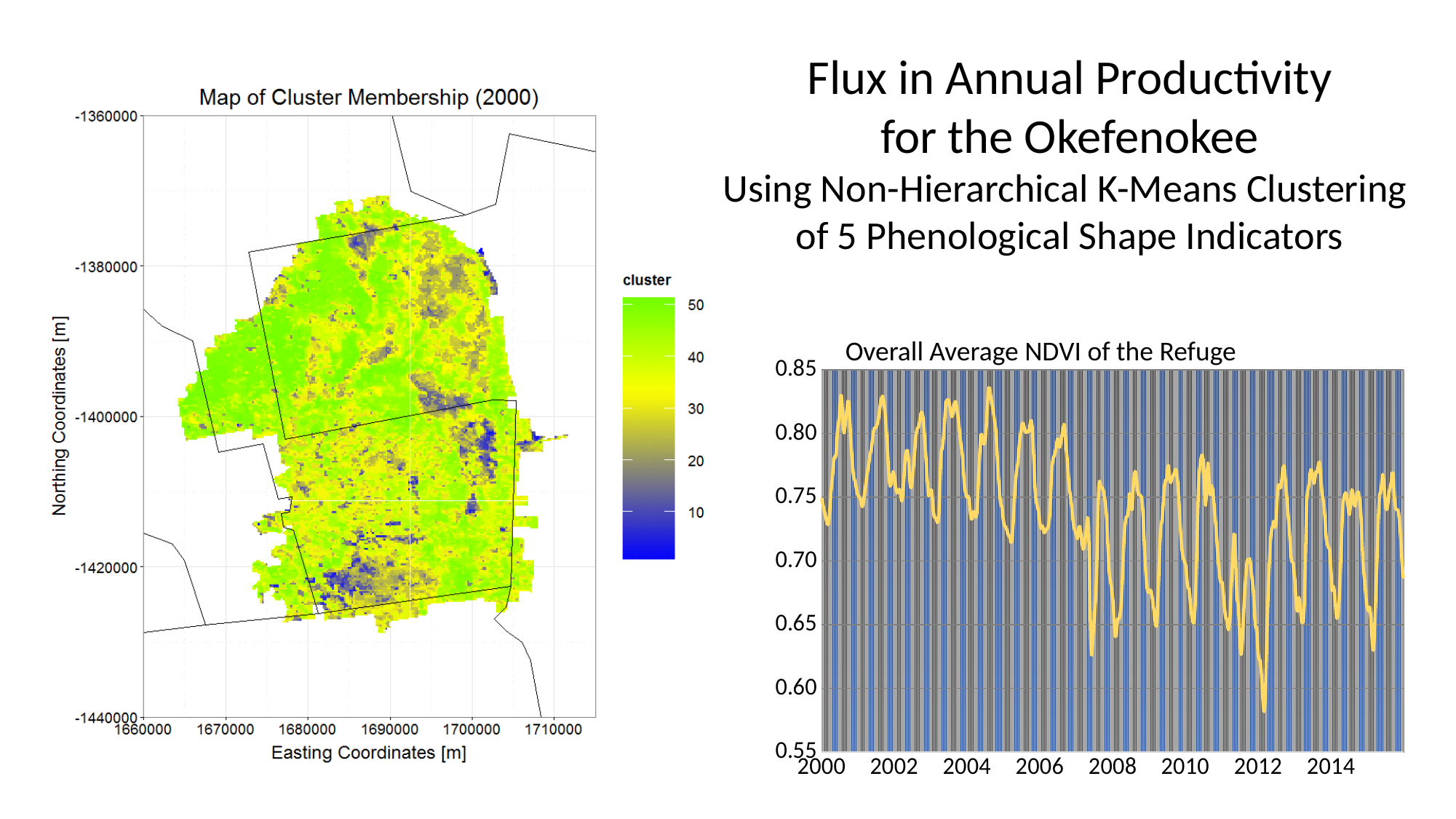
In the 'Overall Average NDVI of the Refuge' chart, is the lowest value reached in 2008 greater or less than 0.65? less In the 'Overall Average NDVI of the Refuge' chart, what is the highest value shown on the y axis? 0.85 What is the title of the chart on the right of the slide? Overall Average NDVI of the Refuge In the 'Map of Cluster Membership (2000)', what is the highest cluster value shown on the colour legend? 50 In the 'Map of Cluster Membership (2000)', what is the lowest cluster value labelled on the colour legend? 10 What kind of chart is the 'Overall Average NDVI of the Refuge' chart on the right of the slide? line chart In the 'Overall Average NDVI of the Refuge' chart, is the highest value reached in 2000 greater or less than 0.80? greater In the 'Overall Average NDVI of the Refuge' chart, do the peak values generally rise or fall from 2000 to 2014? fall In the 'Overall Average NDVI of the Refuge' chart, is the lowest value reached around 2012 greater or less than 0.60? less In the 'Map of Cluster Membership (2000)', what is the label of the x axis? Easting Coordinates [m] In the 'Overall Average NDVI of the Refuge' chart, what is the first year labelled on the x axis? 2000